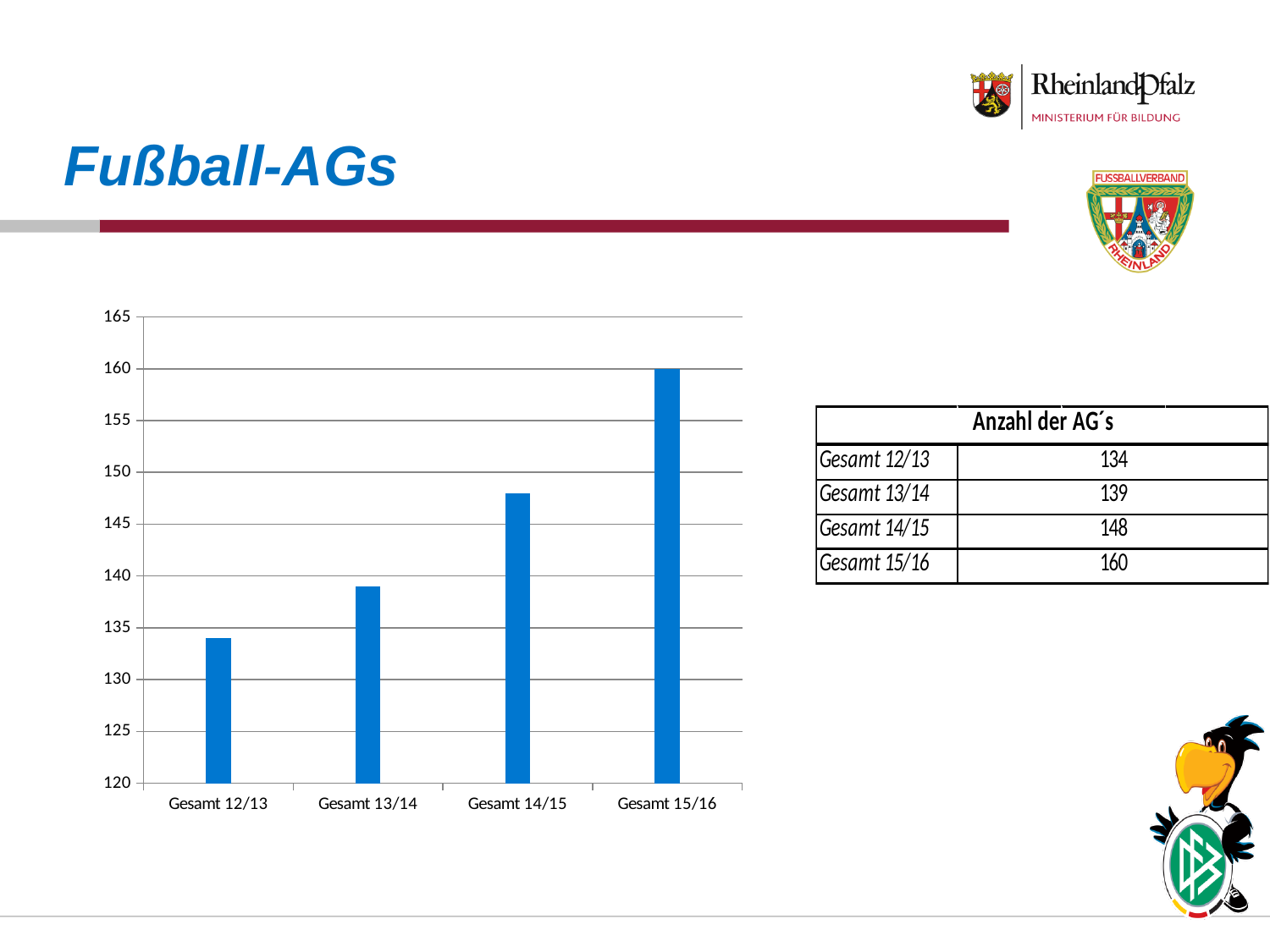
What is the value for Gesamt 14/15? 148 Is the value for Gesamt 13/14 greater or less than 140? less What is the value for Gesamt 15/16? 160 What is the value for Gesamt 12/13? 134 What is the difference between the values for Gesamt 15/16 and Gesamt 12/13? 26 Which category has the highest value? Gesamt 15/16 Which is larger, the value for Gesamt 13/14 or the value for Gesamt 14/15? Gesamt 14/15 What kind of chart is shown on the slide? bar chart Do the values rise or fall from Gesamt 12/13 to Gesamt 15/16? rise What is the difference between the values for Gesamt 14/15 and Gesamt 13/14? 9 Which category has the lowest value? Gesamt 12/13 How many categories are plotted on the x axis of the chart? 4